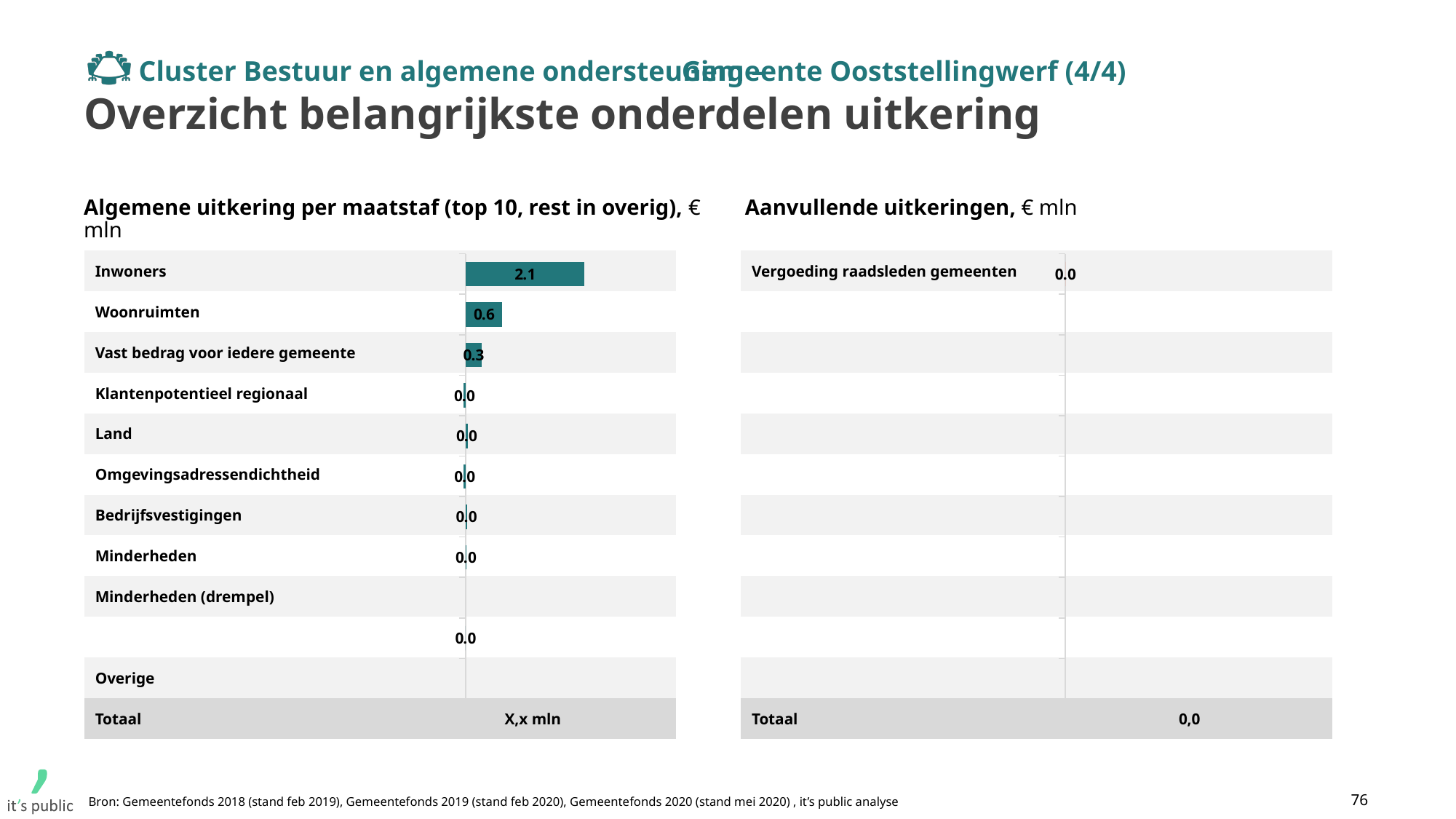
In what unit are the values in the right chart 'Aanvullende uitkeringen' expressed, according to its title? € mln In the left chart 'Algemene uitkering per maatstaf', what is the value for Land? 0.0 In the left chart 'Algemene uitkering per maatstaf', what is the value for Inwoners? 2.1 What kind of chart is the left chart 'Algemene uitkering per maatstaf'? bar chart In the left chart 'Algemene uitkering per maatstaf', what is the difference between the values for Woonruimten and Vast bedrag voor iedere gemeente? 0.3 In the left chart 'Algemene uitkering per maatstaf', what is the value for Woonruimten? 0.6 In the left chart 'Algemene uitkering per maatstaf', which is larger: Woonruimten or Vast bedrag voor iedere gemeente? Woonruimten In the right chart 'Aanvullende uitkeringen', what is the value for Vergoeding raadsleden gemeenten? 0.0 In the left chart 'Algemene uitkering per maatstaf', what is the difference between the values for Inwoners and Woonruimten? 1.5 In the right chart 'Aanvullende uitkeringen', what is the Totaal shown? 0,0 In the left chart 'Algemene uitkering per maatstaf', which category has the highest value? Inwoners In the left chart 'Algemene uitkering per maatstaf', what is the value for Vast bedrag voor iedere gemeente? 0.3